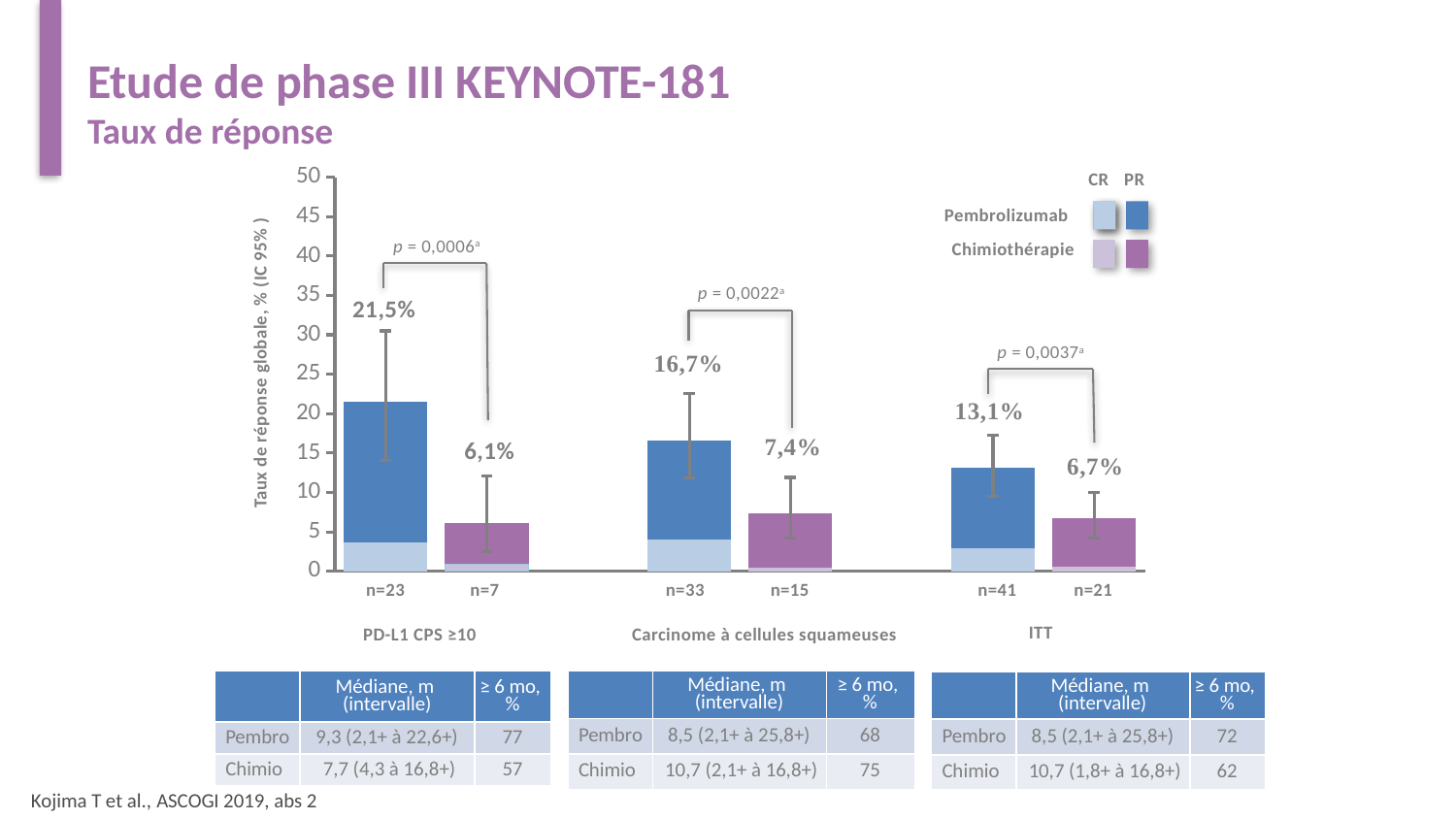
What is the overall response rate for Chimiothérapie in the Carcinome à cellules squameuses group? 7,4% Which bar shows the lowest overall response rate on the chart? Chimiothérapie, PD-L1 CPS ≥10 (6,1%) What type of chart is used to show the response rates? Bar chart In the Carcinome à cellules squameuses group, which has the higher overall response rate, Pembrolizumab or Chimiothérapie? Pembrolizumab What is the overall response rate for Pembrolizumab in the ITT group? 13,1% How many patient subgroups are shown on the x axis of the chart? 3 What is the overall response rate for Chimiothérapie in the ITT group? 6,7% Which bar shows the highest overall response rate on the chart? Pembrolizumab, PD-L1 CPS ≥10 (21,5%) Is the Pembrolizumab response rate in the ITT group greater or less than 10? greater What is the p-value shown for the comparison in the ITT group? p = 0,0037 What is the overall response rate for Pembrolizumab in the PD-L1 CPS ≥10 group? 21,5% What is the difference in overall response rate between Pembrolizumab and Chimiothérapie in the PD-L1 CPS ≥10 group? 15,4%